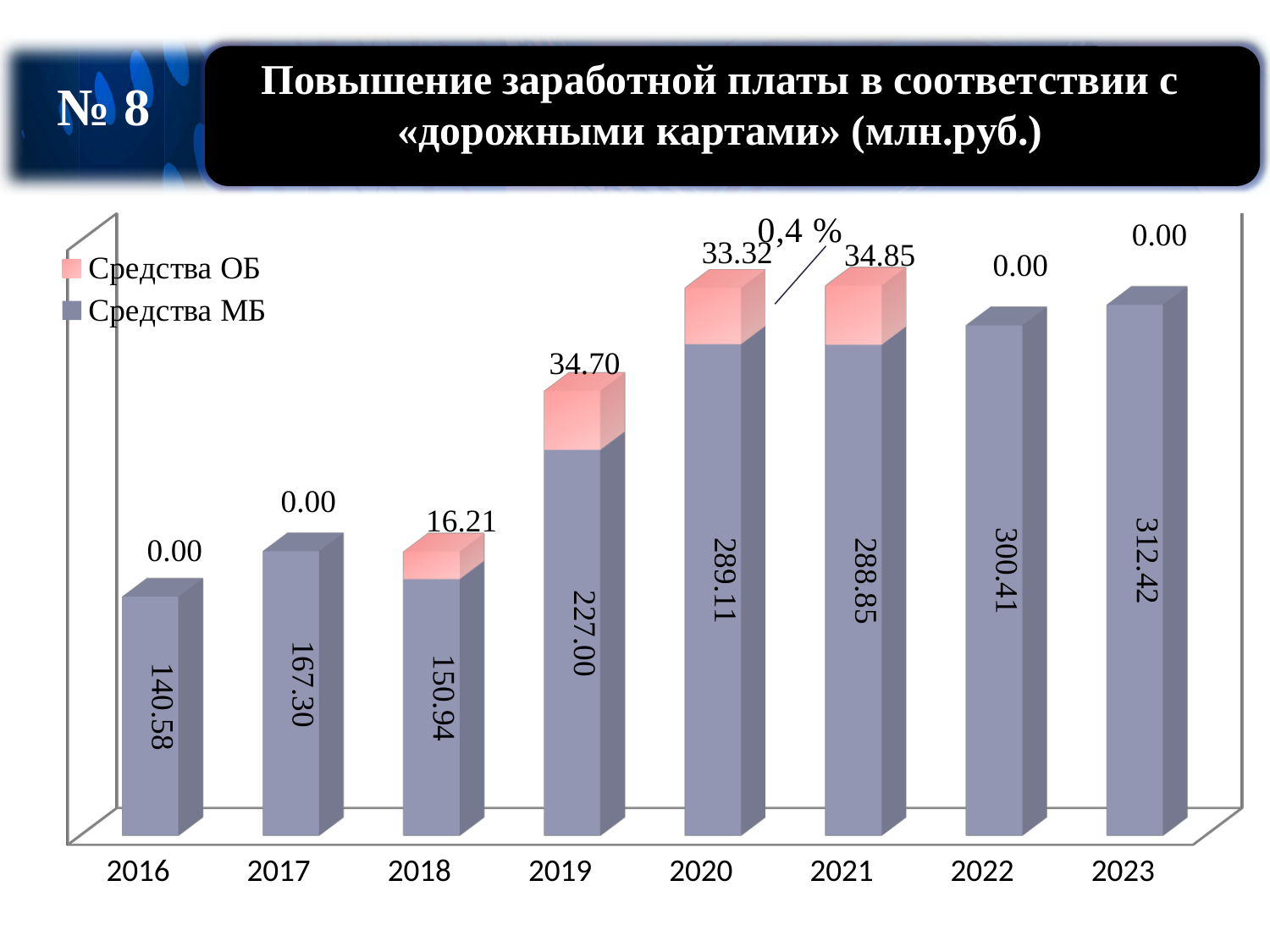
What is the value of Средства ОБ for 2018? 16.21 What is the value of Средства МБ for 2019? 227.00 Which year has the highest value of Средства МБ? 2023 What is the difference between the Средства МБ values for 2023 and 2022? 12.01 What kind of chart is shown on the slide? Stacked bar chart How many years are shown on the x axis? 8 What is the total of the stacked bar for 2020? 322.43 What is the value of Средства ОБ for 2021? 34.85 Which is larger, the Средства ОБ value for 2019 or for 2020? 2019 What is the value of Средства МБ for 2023? 312.42 Which year has the lowest value of Средства МБ? 2016 How many series does the legend list? 2